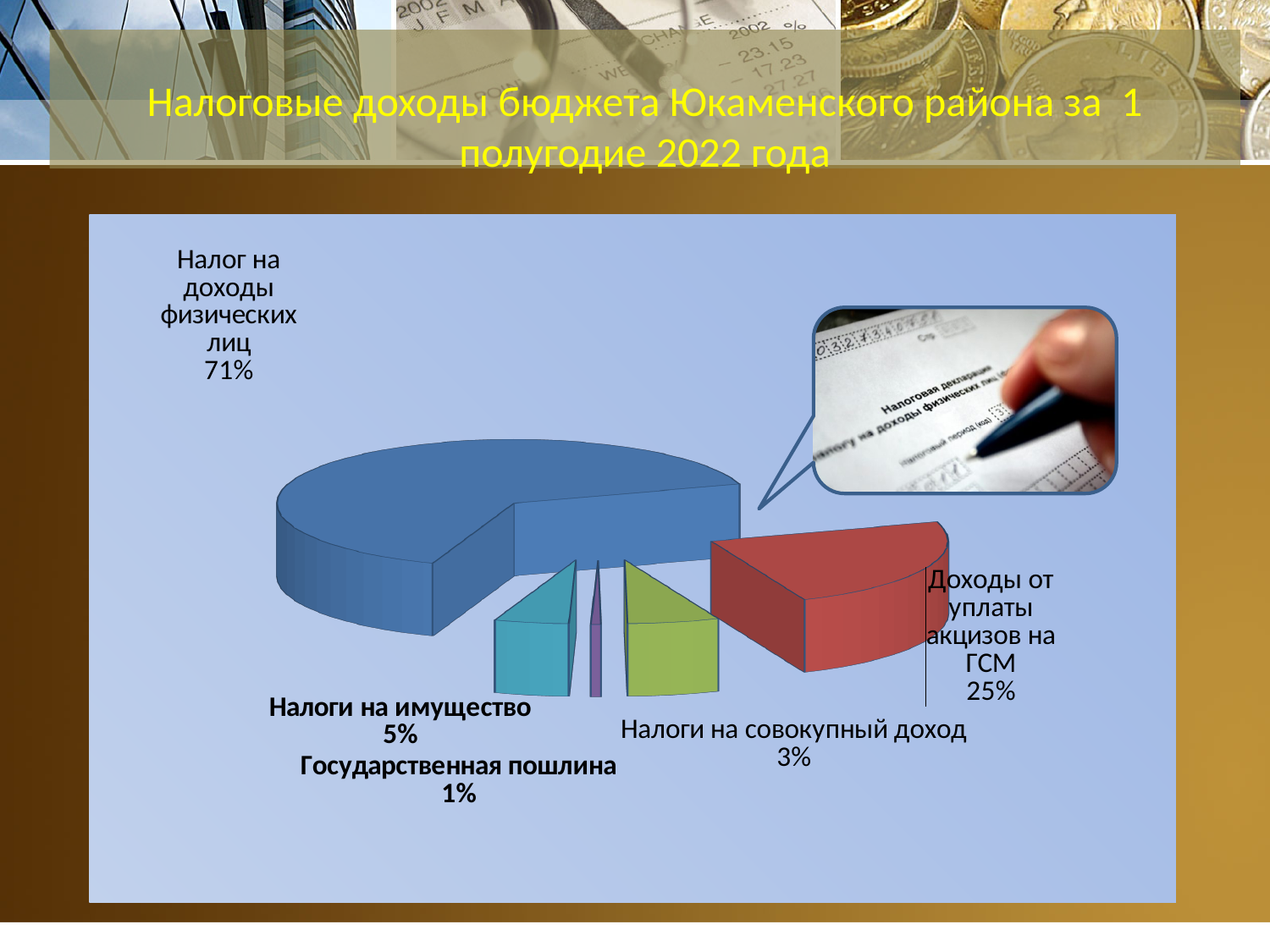
Which category has the smallest slice of the pie? Государственная пошлина What is the value shown for "Налоги на совокупный доход"? 3% What is the value shown for "Налоги на имущество"? 5% What is the difference between the shares of "Налог на доходы физических лиц" and "Доходы от уплаты акцизов на ГСМ"? 46% What is the value shown for "Государственная пошлина"? 1% What share of the pie does "Налог на доходы физических лиц" have? 71% What kind of chart is shown on the slide? Pie chart How many slices does the pie chart have? 5 Which category has the largest slice of the pie? Налог на доходы физических лиц What share of the pie does "Доходы от уплаты акцизов на ГСМ" have? 25% Which is larger: "Налоги на имущество" or "Налоги на совокупный доход"? Налоги на имущество What is the title of the slide containing the chart? Налоговые доходы бюджета Юкаменского района за 1 полугодие 2022 года